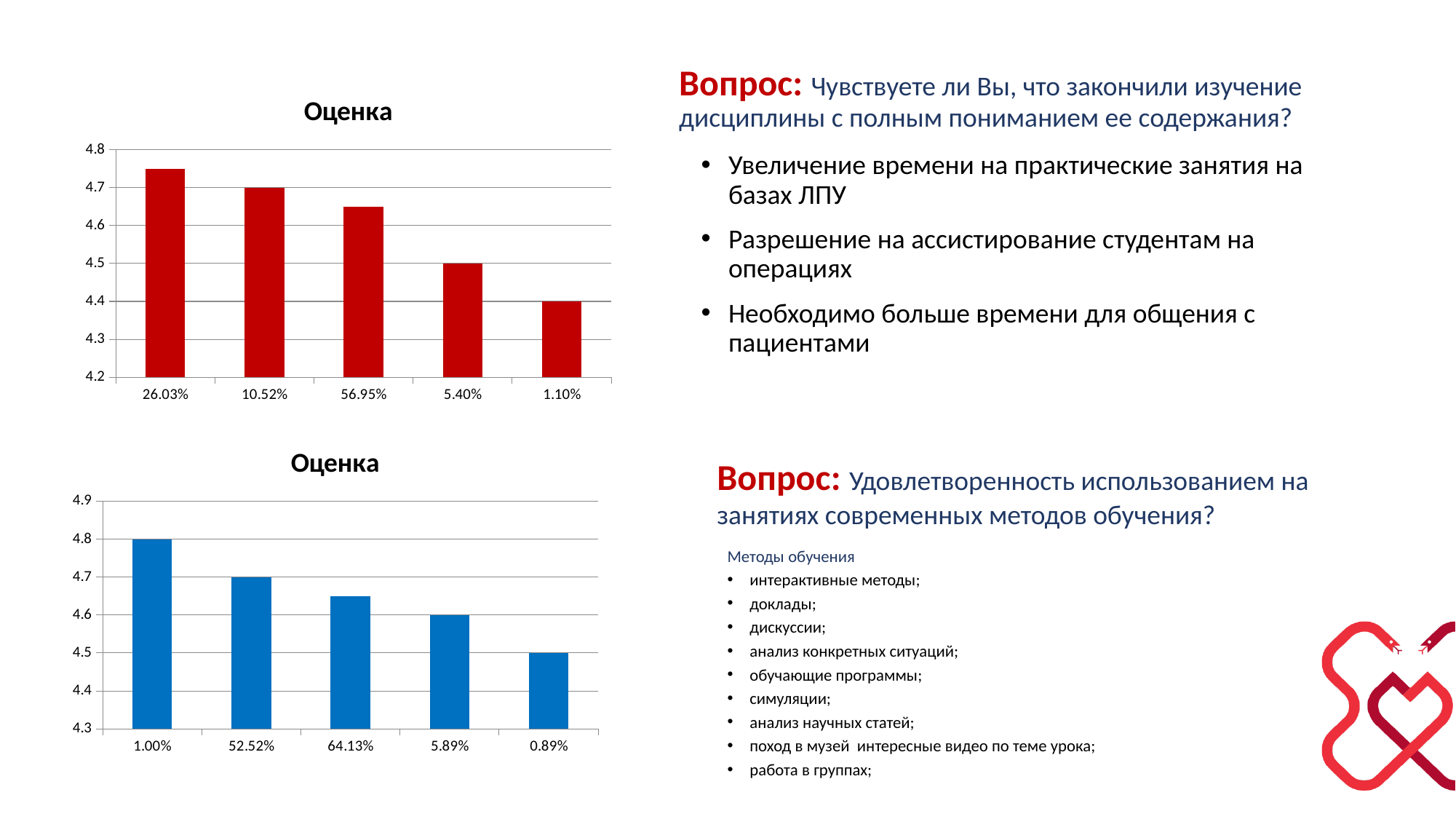
On the bottom chart, what is the value for the category 0.89%? 4.5 On the top chart, which category has the lowest value? 1.10% On the bottom chart, what is the difference between the values for 1.00% and 0.89%? 0.3 On the top chart, how many bars are plotted? 5 On the top chart, which category has the highest value? 26.03% On the top chart, what is the value for the category 1.10%? 4.4 On the top chart, what is the value for the category 10.52%? 4.7 On the bottom chart, what is the value for the category 1.00%? 4.8 What type of chart is the bottom chart? bar chart On the bottom chart, which category has the lowest value? 0.89% On the top chart, do the values rise or fall from left to right? fall On the top chart, is the value for 56.95% greater or less than 4.6? greater